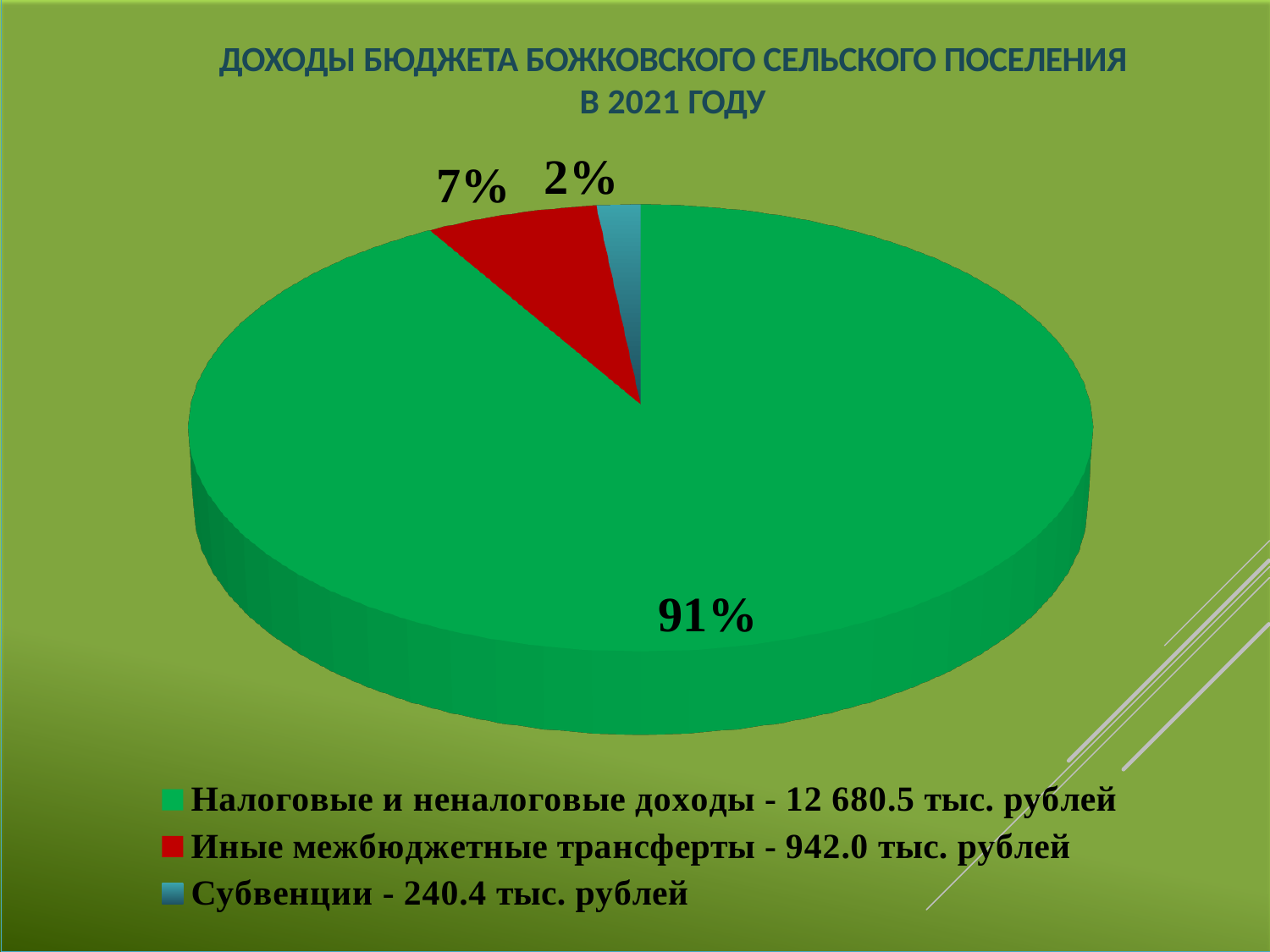
Which category has the largest slice of the pie? Налоговые и неналоговые доходы What amount in thousand rubles does the legend give for "Субвенции"? 240.4 тыс. рублей How many slices does the pie chart have? 3 What share of the pie does "Иные межбюджетные трансферты" take? 7% How many entries does the legend list? 3 What kind of chart is shown on the slide? Pie chart What colour is the slice for "Иные межбюджетные трансферты"? Red What is the difference in percentage points between the "Иные межбюджетные трансферты" slice and the "Субвенции" slice? 5 percentage points Which slice is larger: "Иные межбюджетные трансферты" or "Субвенции"? Иные межбюджетные трансферты What share of the pie does "Субвенции" take? 2% What share of the pie does "Налоговые и неналоговые доходы" take? 91% Which category has the smallest slice of the pie? Субвенции